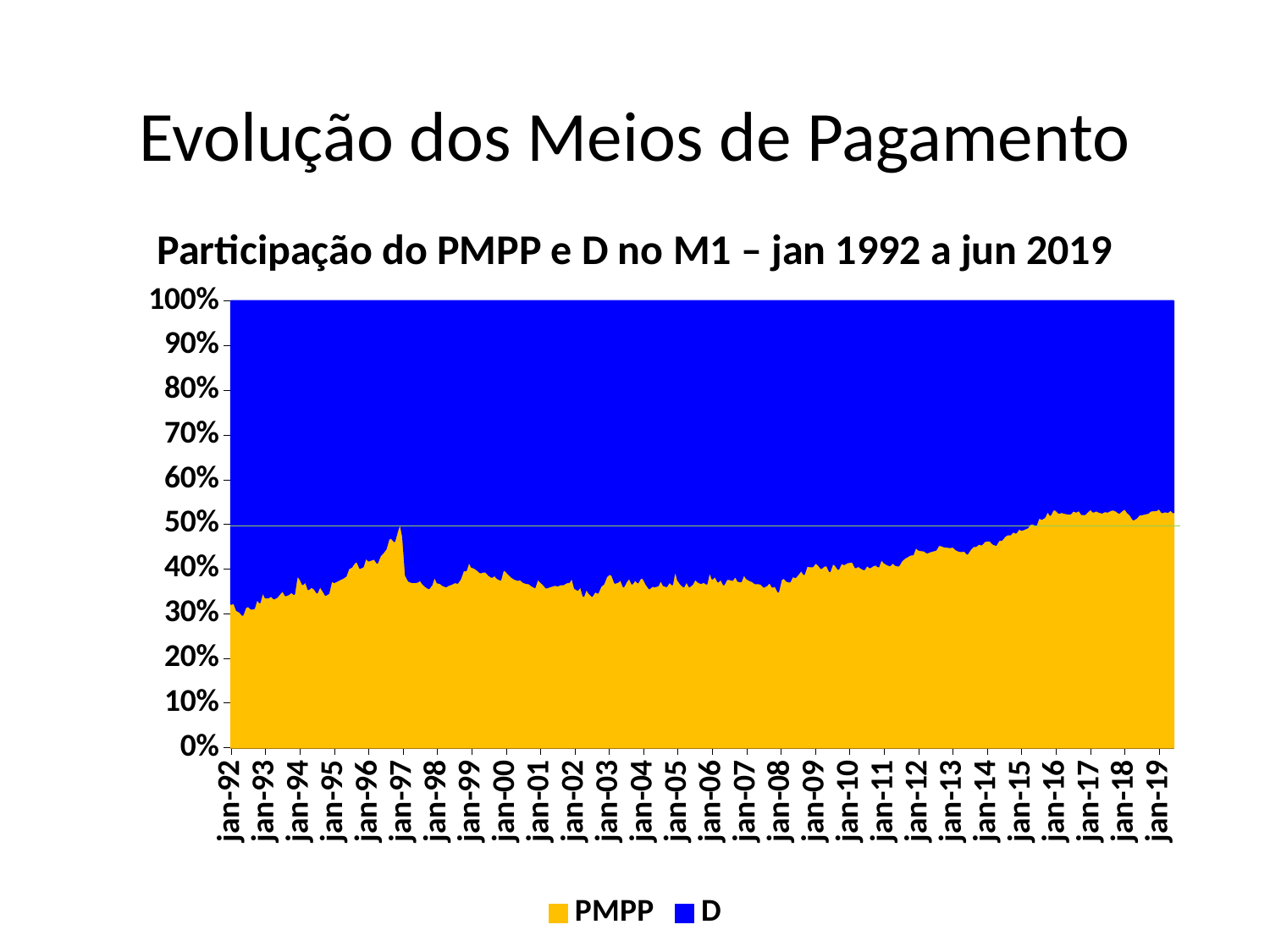
Does the share of PMPP generally rise or fall from jan-92 to jan-19? Rise Is the value for PMPP at jan-17 greater or less than 50%? greater At jan-92, which series has the larger share, PMPP or D? D How many series does the legend list? 2 Is the share of D at jan-92 greater or less than 60%? greater At jan-17, which series has the larger share, PMPP or D? PMPP Which colour represents the PMPP series? Yellow How many year labels are shown on the x axis? 28 Is the value for PMPP at jan-05 greater or less than 40%? less What is the title of the chart? Participação do PMPP e D no M1 – jan 1992 a jun 2019 What kind of chart is shown on the slide? Stacked area chart